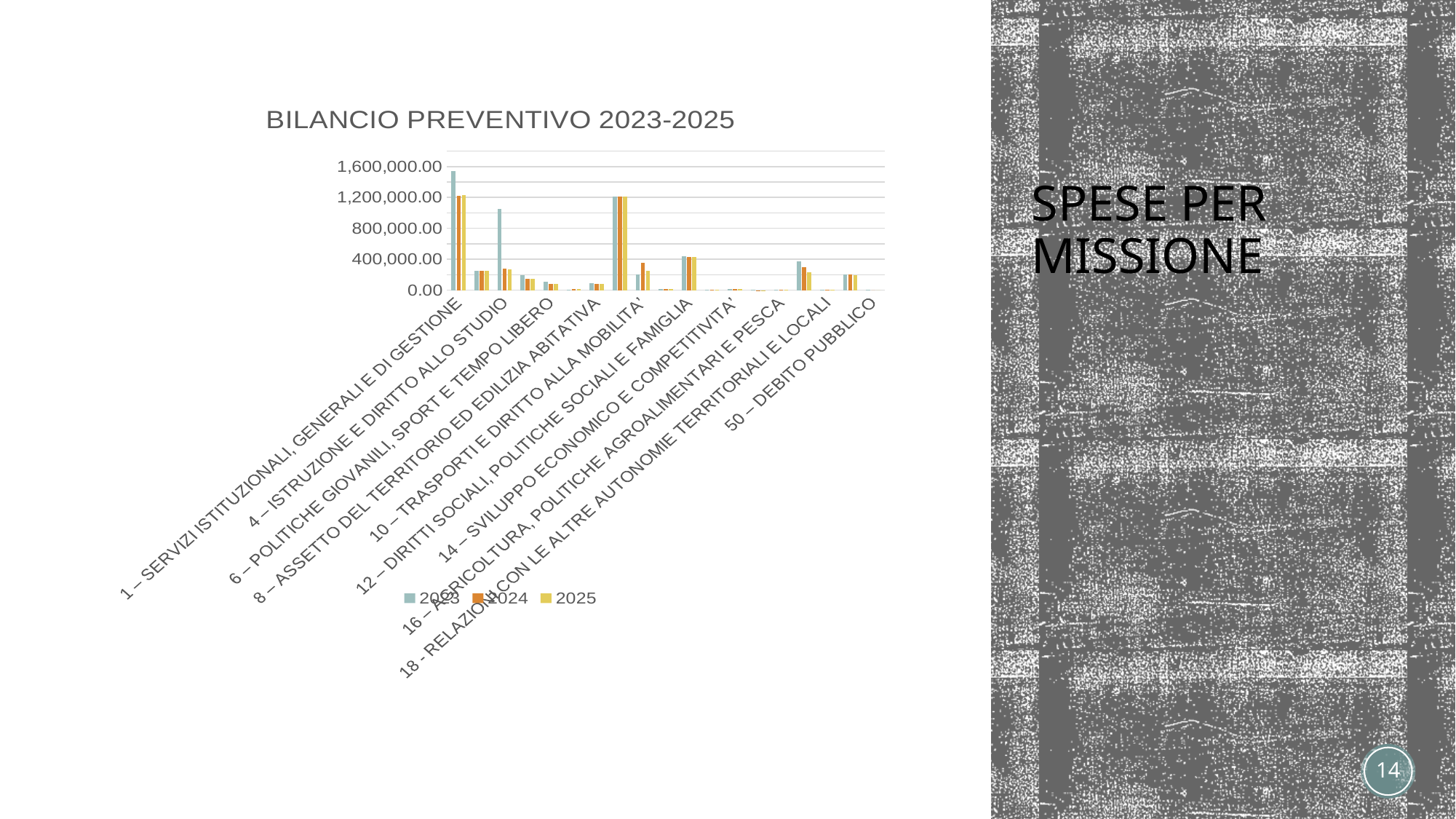
How many series does the legend of the chart list? 3 Which category has the highest 2023 value? 1 – SERVIZI ISTITUZIONALI, GENERALI E DI GESTIONE For 1 – SERVIZI ISTITUZIONALI, GENERALI E DI GESTIONE, which is larger: the 2023 value or the 2024 value? 2023 Is the 2024 value for 4 – ISTRUZIONE E DIRITTO ALLO STUDIO greater or less than 400,000.00? less Which series are listed in the chart legend? 2023, 2024, 2025 Is the 2023 value for 12 – DIRITTI SOCIALI, POLITICHE SOCIALI E FAMIGLIA greater or less than 800,000.00? less What is the title of the chart? BILANCIO PREVENTIVO 2023-2025 What type of chart is shown on the slide? Bar chart Is the 2023 value for 1 – SERVIZI ISTITUZIONALI, GENERALI E DI GESTIONE greater or less than 1,600,000.00? less For 4 – ISTRUZIONE E DIRITTO ALLO STUDIO, which is larger: the 2023 value or the 2025 value? 2023